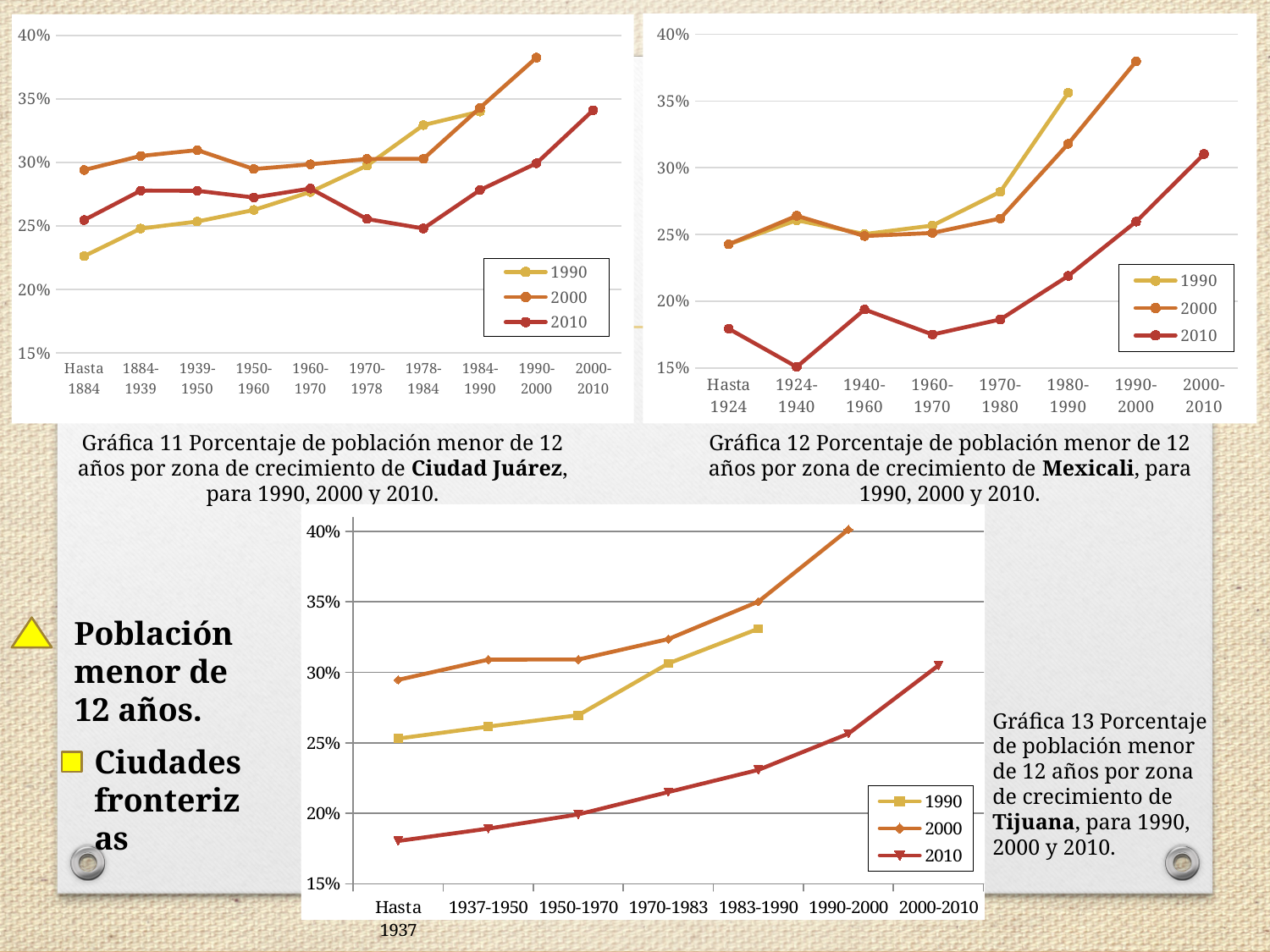
Which city does Gráfica 13 refer to? Tijuana In Gráfica 13 (Tijuana), which growth zone has the highest value for the 2000 series? 1990-2000 In Gráfica 11 (Ciudad Juárez), is the 2010 value for 2000-2010 greater or less than 30%? greater What kind of chart is Gráfica 11 (Ciudad Juárez)? Line chart How many series does the legend of Gráfica 12 (Mexicali) list? 3 How many growth-zone categories are shown on the x axis of Gráfica 12 (Mexicali)? 8 In Gráfica 11 (Ciudad Juárez), for 1970-1978, which series has the larger value, 2000 or 2010? 2000 How many growth-zone categories are shown on the x axis of Gráfica 13 (Tijuana)? 7 In Gráfica 13 (Tijuana), does the 2010 series rise or fall along the x axis? Rises In Gráfica 12 (Mexicali), which growth zone has the lowest value for the 2010 series? 1924-1940 In Gráfica 12 (Mexicali), is the 2000 value for 1990-2000 greater or less than 35%? greater In Gráfica 11 (Ciudad Juárez), is the 1990 value for Hasta 1884 greater or less than 25%? less